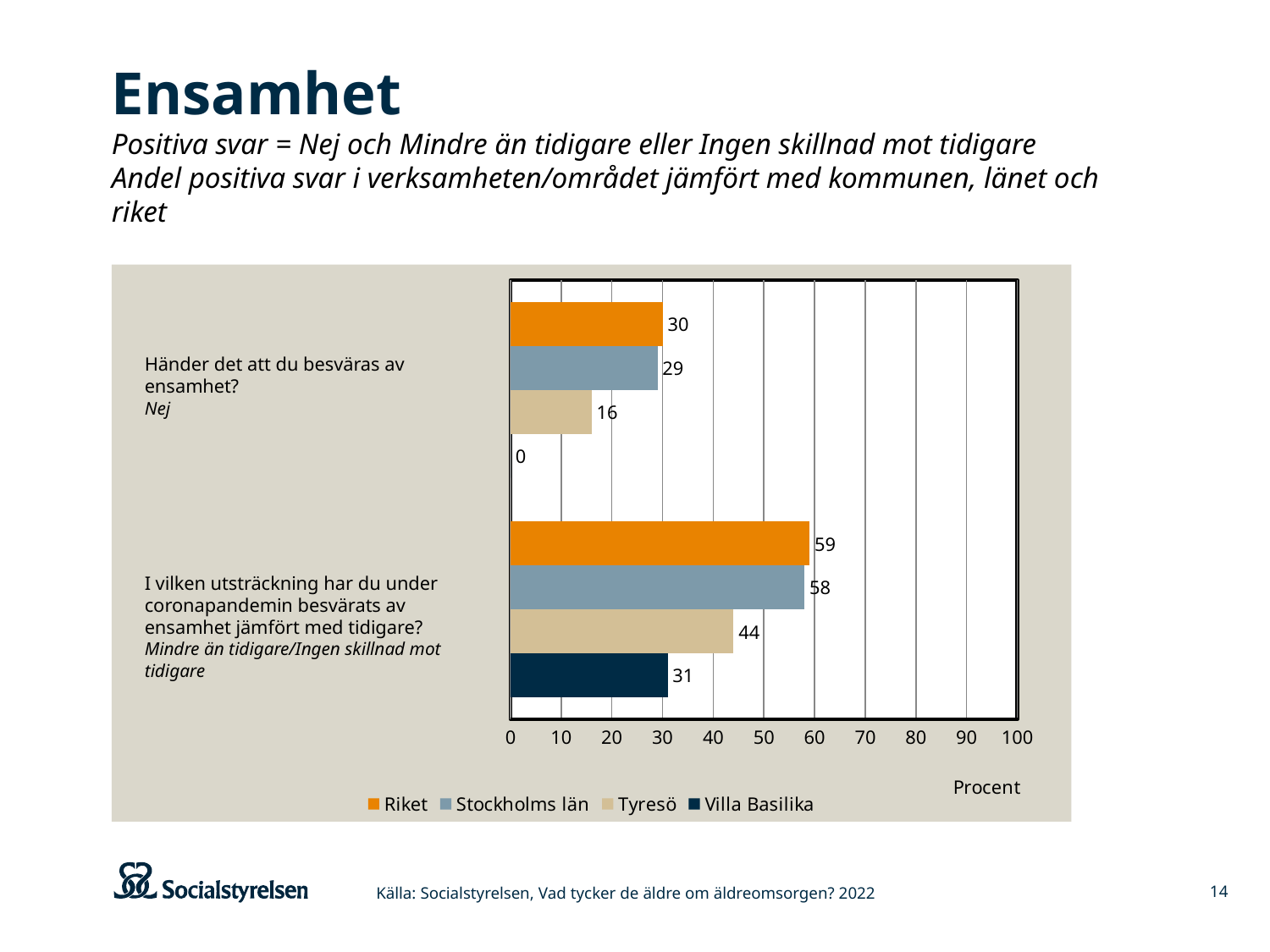
What is the value for Villa Basilika on the question "Händer det att du besväras av ensamhet?"? 0 What is the value for Tyresö on the question "Händer det att du besväras av ensamhet?"? 16 What type of chart is shown on the slide? bar chart Which series has the highest value on the question "I vilken utsträckning har du under coronapandemin besvärats av ensamhet jämfört med tidigare?"? Riket What is the difference between Riket and Tyresö on the question "I vilken utsträckning har du under coronapandemin besvärats av ensamhet jämfört med tidigare?"? 15 What is the label of the x axis? Procent What is the value for Villa Basilika on the question "I vilken utsträckning har du under coronapandemin besvärats av ensamhet jämfört med tidigare?"? 31 Which is larger on the question "Händer det att du besväras av ensamhet?": Stockholms län or Tyresö? Stockholms län How many series does the legend list? 4 What is the value for Riket on the question "Händer det att du besväras av ensamhet?"? 30 Which series has the lowest value on the question "Händer det att du besväras av ensamhet?"? Villa Basilika What is the value for Stockholms län on the question "I vilken utsträckning har du under coronapandemin besvärats av ensamhet jämfört med tidigare?"? 58